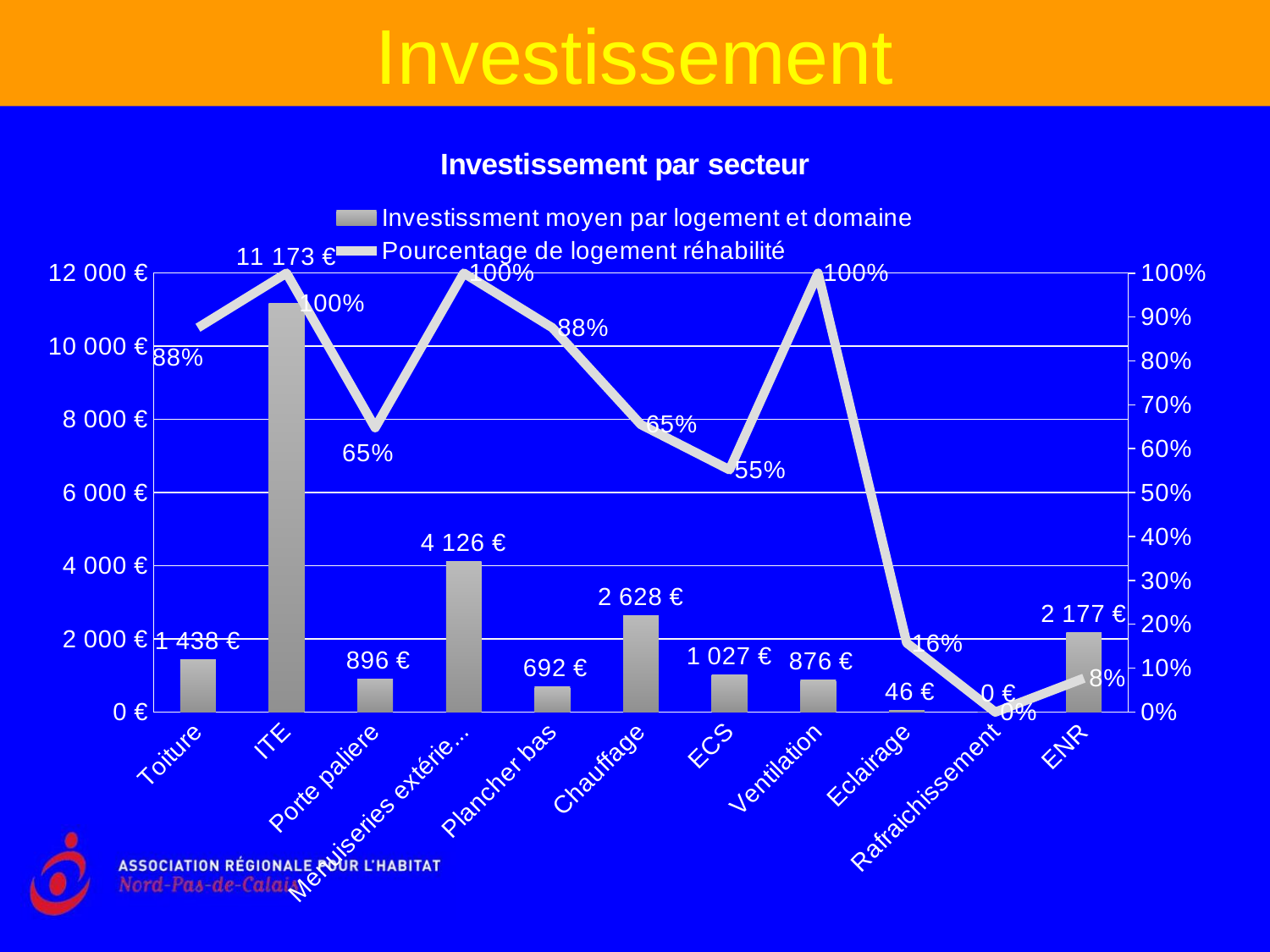
How many series does the legend list? 2 Which category has the highest average investment per dwelling? ITE How many categories are shown on the x axis? 11 What is the Pourcentage de logement réhabilité for Eclairage? 16% What is the average investment per dwelling (Investissment moyen par logement et domaine) for ITE? 11 173 € What kind of chart is shown on the slide? Combined bar and line chart What is the average investment per dwelling for Chauffage? 2 628 € What is the Pourcentage de logement réhabilité for ECS? 55% What is the difference in average investment per dwelling between Menuiseries extérie... and Plancher bas? 3 434 € What is the title of the chart? Investissement par secteur Which has a higher average investment per dwelling, ENR or Toiture? ENR Which category has the lowest average investment per dwelling? Rafraichissement